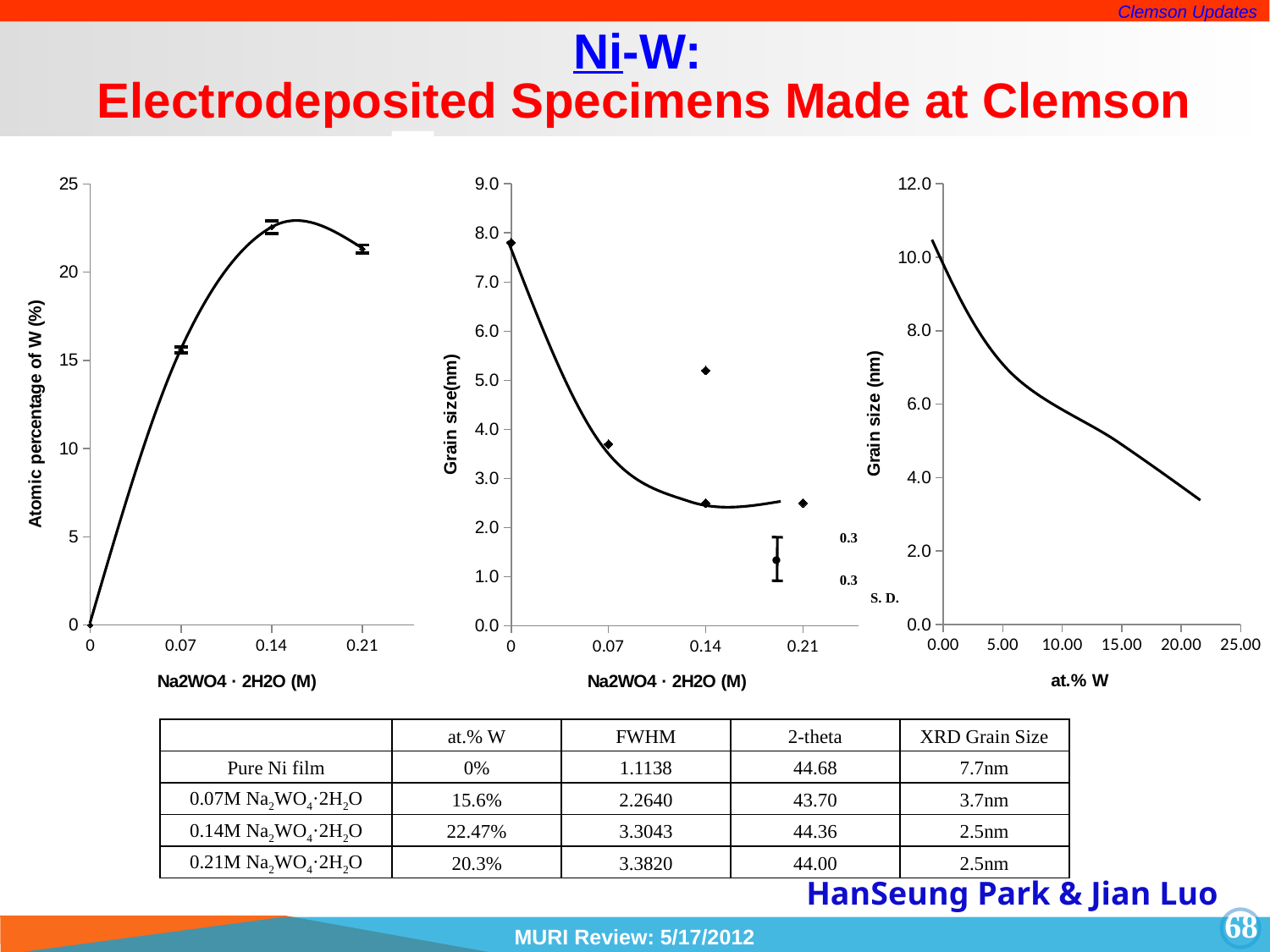
In the right chart, is the grain size at 5.00 at.% W greater or less than 6.0 nm? greater In the right chart (Grain size vs at.% W), does the grain size rise or fall as at.% W increases? fall In the left chart, which x-axis value has the lowest atomic percentage of W? 0 In the middle chart, is the grain size at 0.07 M greater or less than 4.0 nm? less What type of chart is the left chart (Atomic percentage of W vs Na2WO4 · 2H2O)? line chart In the middle chart, at which x-axis value is the grain size highest? 0 In the middle chart (Grain size vs Na2WO4 · 2H2O), is the grain size at 0 M greater or less than 7.0 nm? greater In the left chart, is the atomic percentage of W at 0.14 M larger or smaller than at 0.07 M? larger In the left chart, how many data points are plotted along the x axis? 4 What is the x-axis title of the right chart? at.% W